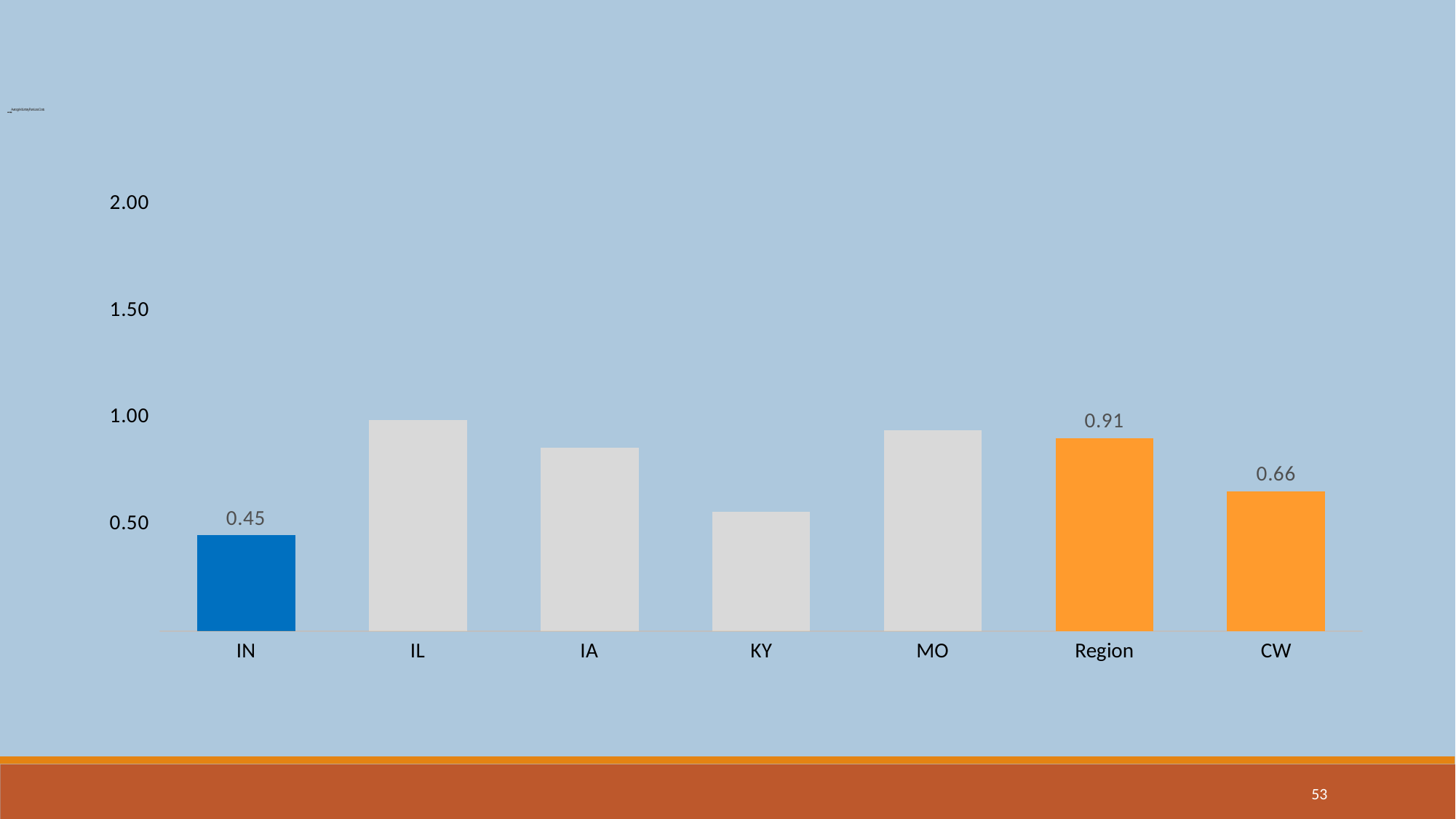
What is the difference between the values for Region and IN? 0.46 What is the value for IN? 0.45 Which is larger, the value for CW or the value for IN? CW What colour is the bar for IN? blue What kind of chart is shown on the slide? bar chart Is the value for IA greater or less than 0.50? greater What is the difference between the values for Region and CW? 0.25 Which category has the lowest value? IN Is the value for MO greater or less than 1.00? less What is the value for CW? 0.66 How many categories are shown on the x axis? 7 What is the value for Region? 0.91